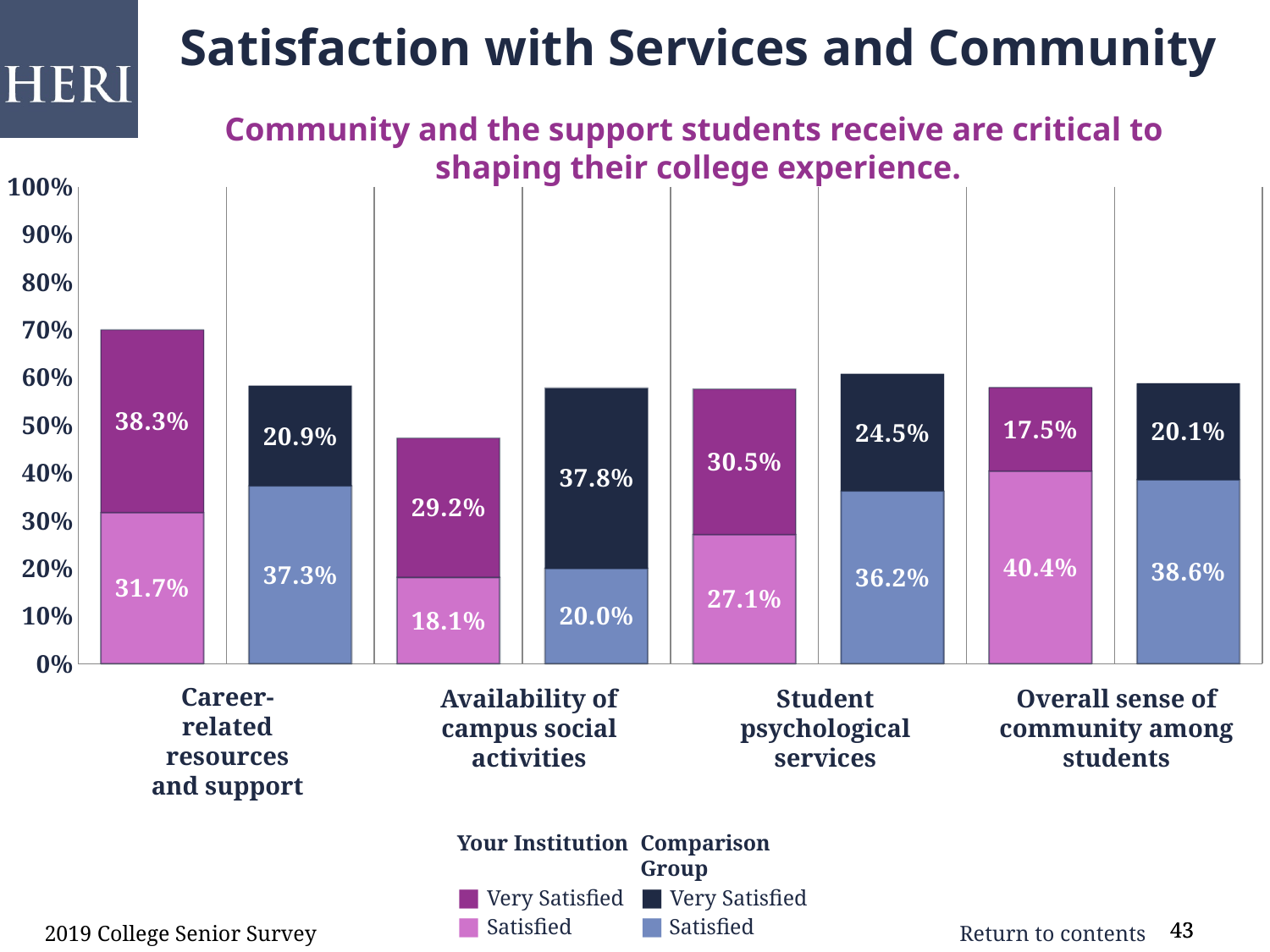
For student psychological services, which is larger: Your Institution's Very Satisfied share or the Comparison Group's Very Satisfied share? Your Institution What is the difference between the Comparison Group's Very Satisfied share and Your Institution's Very Satisfied share for availability of campus social activities? 8.6% Which category has the highest Very Satisfied percentage for Your Institution? Career-related resources and support Is the total stacked bar for Your Institution on availability of campus social activities greater or less than 50%? less What percentage of Your Institution students were Satisfied with the overall sense of community among students? 40.4% How many categories are shown on the x axis of the chart? 4 What is the total percentage (Satisfied plus Very Satisfied) for the Comparison Group on availability of campus social activities? 57.8% What percentage of the Comparison Group was Satisfied with student psychological services? 36.2% What percentage of Your Institution students were Very Satisfied with career-related resources and support? 38.3% What is the total percentage (Satisfied plus Very Satisfied) for Your Institution on career-related resources and support? 70.0% Which category has the lowest Very Satisfied percentage for Your Institution? Overall sense of community among students What type of chart is shown on the slide? Stacked bar chart